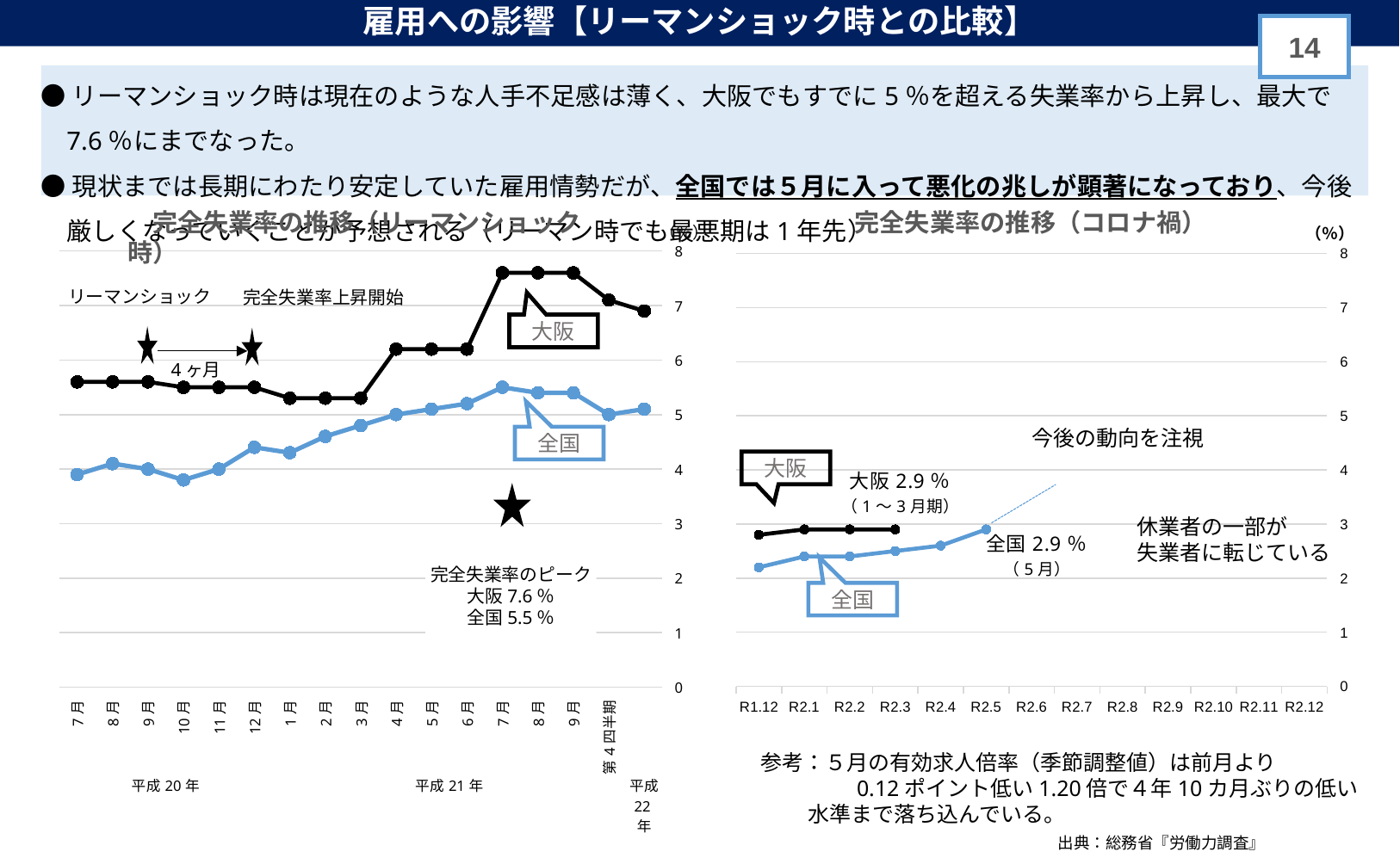
In the right chart (コロナ禍), does the 全国 line rise or fall from R1.12 to R2.5? rise In the left chart (リーマンショック時), what was the peak unemployment rate for 全国? 5.5% In the left chart (リーマンショック時), which series is consistently higher, 大阪 or 全国? 大阪 In the left chart (リーマンショック時), what is the difference between the peak rates of 大阪 (7.6%) and 全国 (5.5%)? 2.1 In the right chart (コロナ禍), is the 全国 value for R1.12 greater or less than 3? less How many x-axis categories (months) are shown on the right chart (コロナ禍)? 13 In the left chart (リーマンショック時), what was the peak unemployment rate for 大阪? 7.6% In the left chart (リーマンショック時), is the 大阪 value for 1月 of 平成21年 greater or less than 6? less In the right chart (コロナ禍), what is the 全国 unemployment rate for 5月 (R2.5)? 2.9% What kind of chart is the left chart titled 完全失業率の推移（リーマンショック時）? line chart How many series does the left chart (リーマンショック時) plot? 2 In the right chart (コロナ禍), what is the 大阪 unemployment rate for the 1～3月期? 2.9%